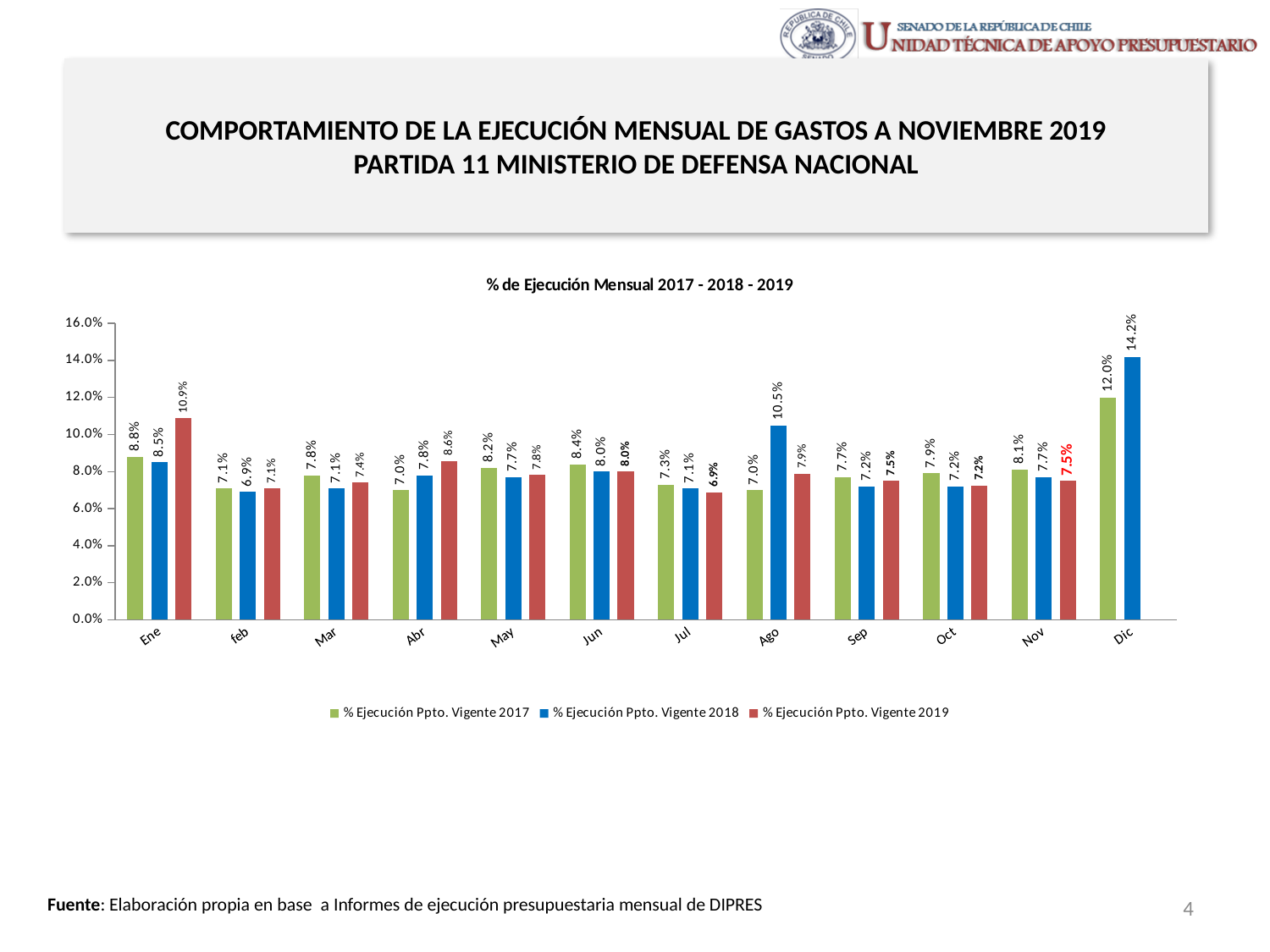
How many series does the legend list? 3 For Ago, which series has the larger value: 2017 or 2018? % Ejecución Ppto. Vigente 2018 What is the value of % Ejecución Ppto. Vigente 2018 for Ago? 10.5% In which month is the % Ejecución Ppto. Vigente 2018 value highest? Dic What is the difference between the 2018 and 2017 values for Dic? 2.2 percentage points How many months are shown on the x axis? 12 In which month is the % Ejecución Ppto. Vigente 2019 value lowest? Jul What is the difference between the 2019 and 2017 values for Ene? 2.1 percentage points What is the value of % Ejecución Ppto. Vigente 2017 for Dic? 12.0% What is the value of % Ejecución Ppto. Vigente 2019 for Ene? 10.9% Which series has no bar for Dic? % Ejecución Ppto. Vigente 2019 What kind of chart is shown on the slide? Bar chart